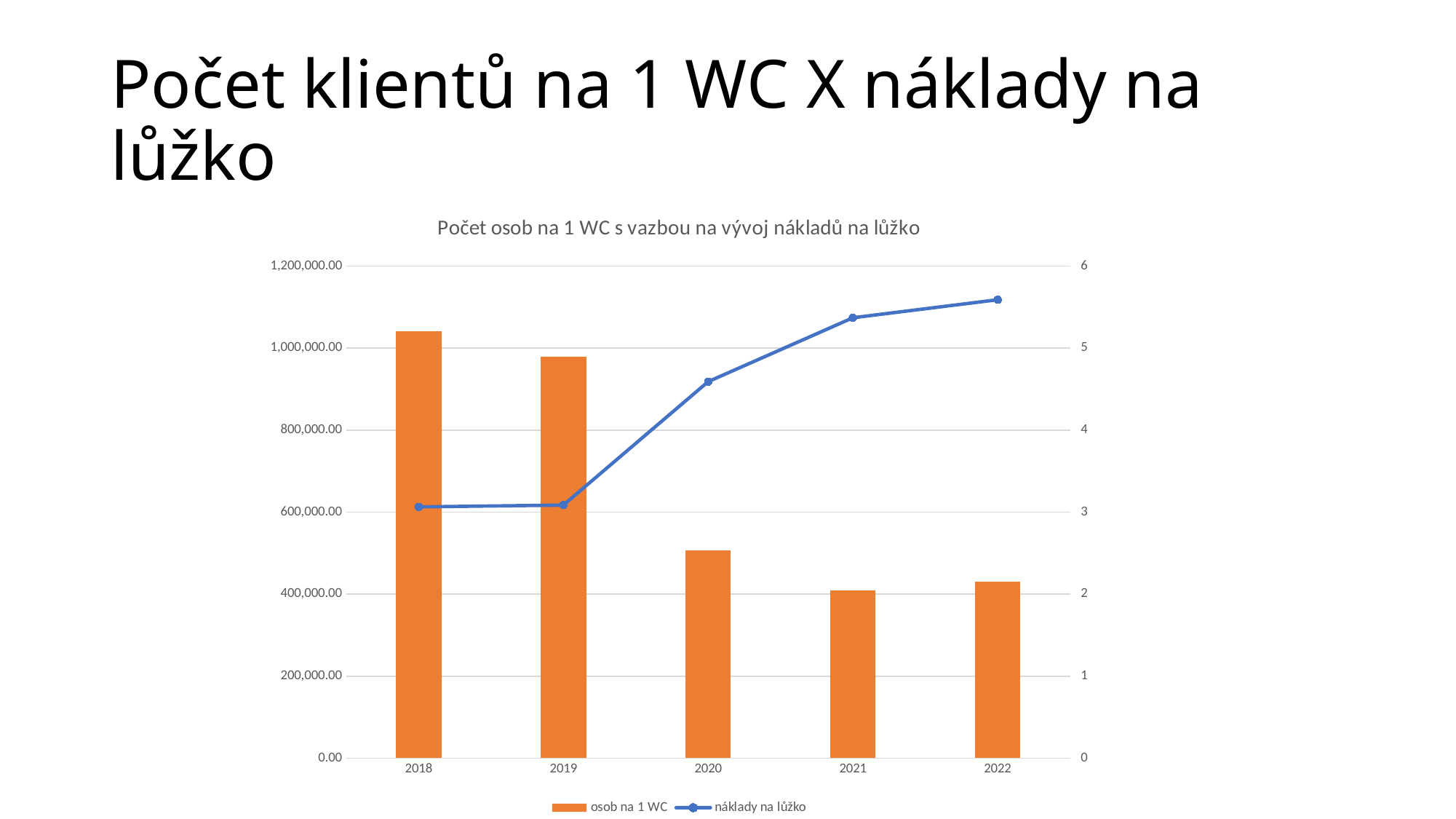
What kind of chart is shown on the slide? A combination bar and line chart Which year has the highest bar for 'osob na 1 WC'? 2018 What is the title of the chart? Počet osob na 1 WC s vazbou na vývoj nákladů na lůžko How many series does the chart legend list? 2 Does the 'náklady na lůžko' line rise or fall from 2018 to 2022? It rises Which year has the highest point on the 'náklady na lůžko' line? 2022 Which is larger, the 'osob na 1 WC' bar for 2019 or for 2020? 2019 How many years are shown on the x axis of the chart? 5